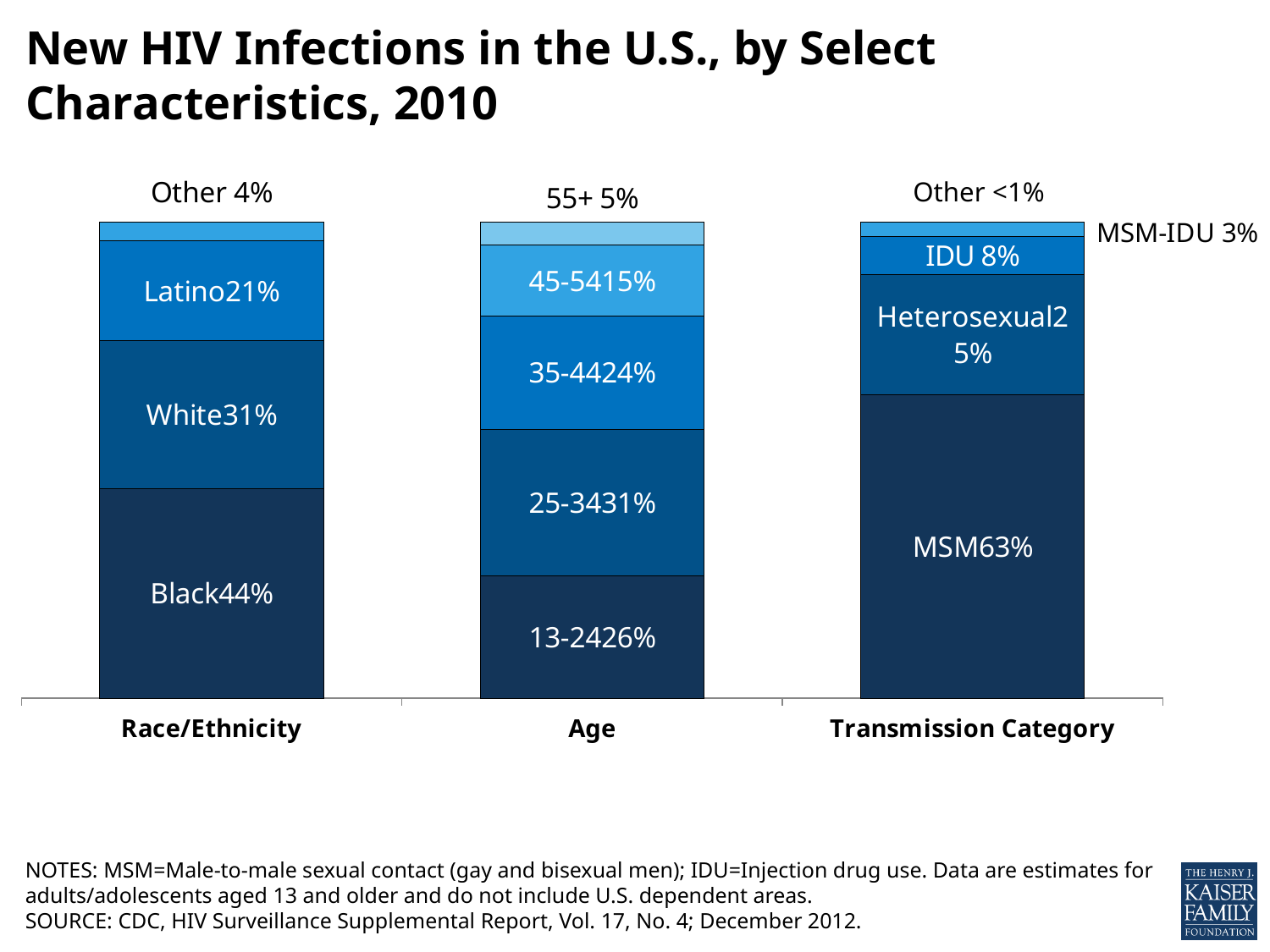
What kind of chart is shown on the slide? Stacked bar chart What percentage is shown for the 25-34 age group in the Age bar? 31% What is the title of the chart? New HIV Infections in the U.S., by Select Characteristics, 2010 What share of new HIV infections in the Race/Ethnicity bar is attributed to Black individuals? 44% How many stacked bars are shown on the chart? 3 Which is larger in the Age bar: the 13-24 share or the 35-44 share? 13-24 How many segments make up the Age bar? 5 Which age group has the smallest share in the Age bar? 55+ What is the difference between the White and Latino shares in the Race/Ethnicity bar? 10 percentage points What percentage is shown for IDU in the Transmission Category bar? 8% What percentage is shown for the Heterosexual segment in the Transmission Category bar? 25% Which segment is the largest in the Transmission Category bar? MSM